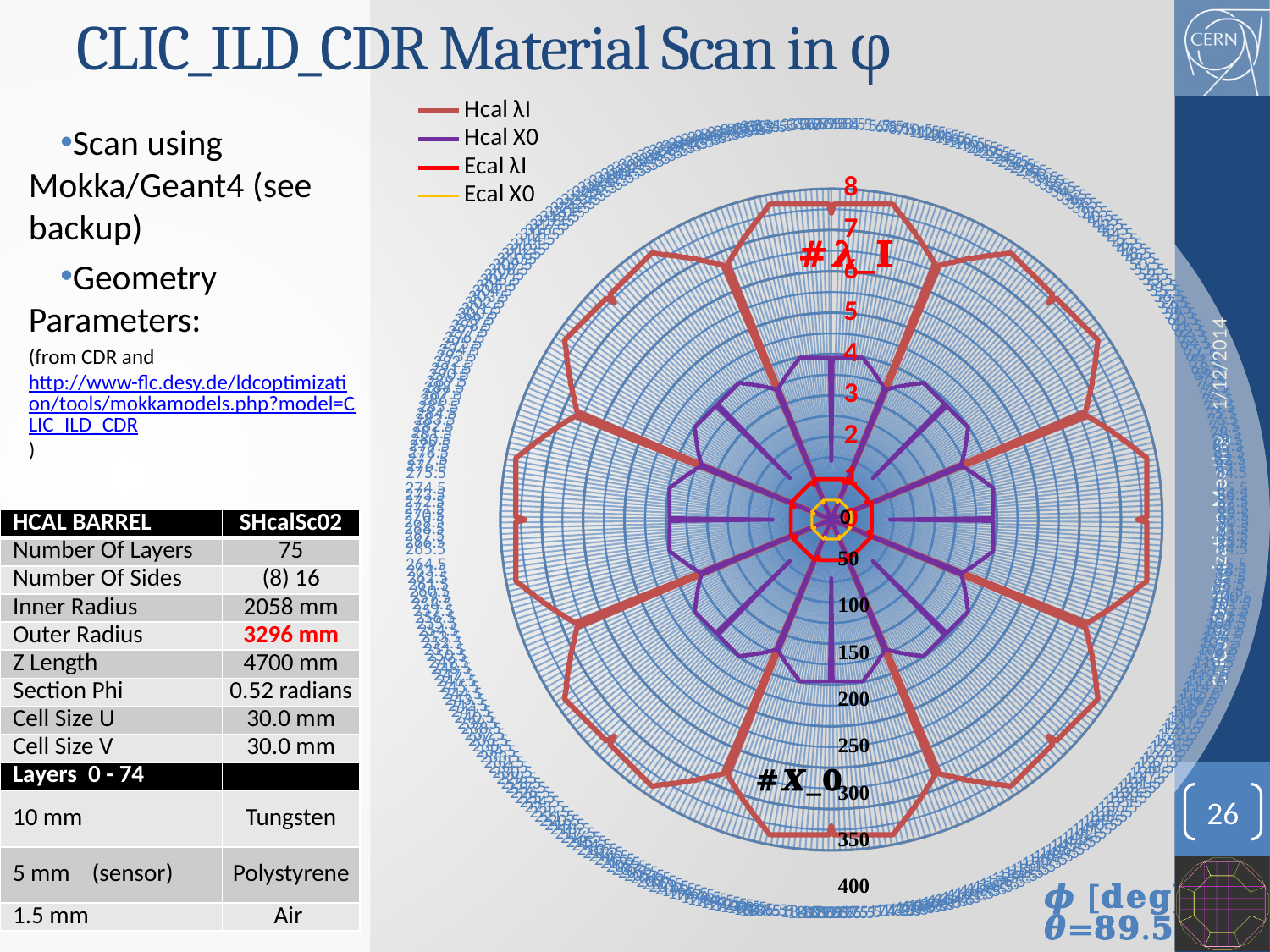
Which series extends farthest from the centre of the chart? Hcal λI Which is larger, Hcal λI or Ecal λI? Hcal λI What is the highest tick value shown on the black X0 radial axis? 400 Is the value for Hcal λI greater or less than 4? greater Which series stays closest to the centre of the chart? Ecal X0 Which is larger, Hcal X0 or Ecal X0? Hcal X0 What is the first entry in the chart legend? Hcal λI Which colour is used for the Ecal X0 series? yellow How many series does the chart legend list? 4 What kind of chart is shown on the slide? radar chart Is the value for Ecal λI greater or less than 2? less Is the value for Ecal X0 greater or less than 50? less